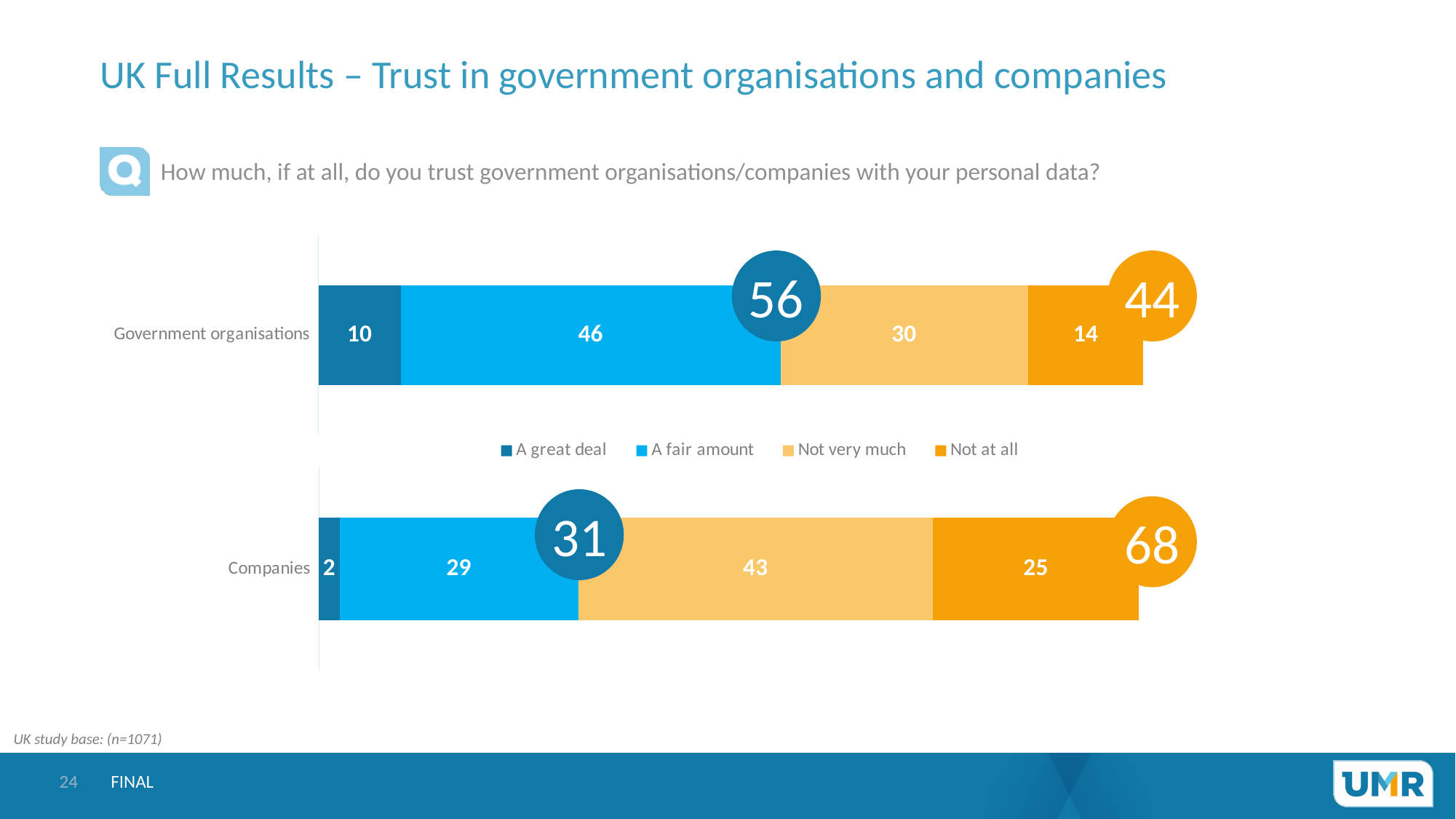
Which legend entry is shown in the darkest blue colour? A great deal What is the value for 'Not at all' for Government organisations? 14 Which category has the higher value for 'Not at all', Government organisations or Companies? Companies What is the difference between the 'A fair amount' values for Government organisations and Companies? 17 How many series does the legend list? 4 What is the value for 'A great deal' for Companies? 2 How many categories are plotted on the chart? 2 What is the value for 'Not very much' for Companies? 43 What is the value for 'A fair amount' for Government organisations? 46 What is the total of 'A great deal' and 'A fair amount' for Government organisations, as shown in the circle label? 56 What is the total of 'Not very much' and 'Not at all' for Companies, as shown in the circle label? 68 What kind of chart is shown on the slide? Stacked bar chart